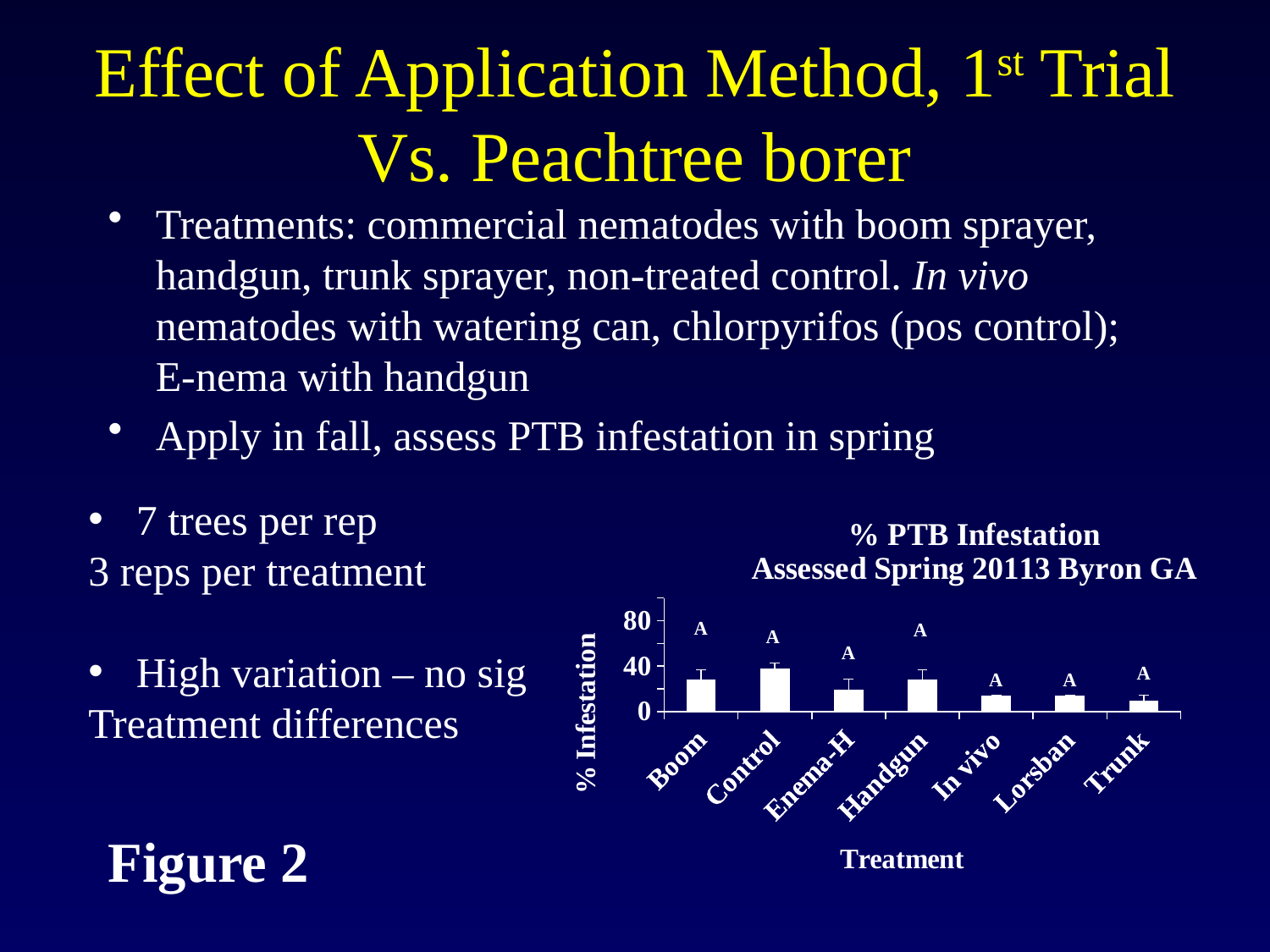
Which has a higher % infestation, Boom or In vivo? Boom Which treatment has the highest % infestation in the chart? Control What kind of chart is shown on the slide? bar chart What is the label on the x axis of the chart? Treatment Is the value for Boom greater or less than 40? less Which has a higher % infestation, Handgun or Lorsban? Handgun Is the value for Enema-H greater or less than 40? less How many treatment categories are plotted on the x axis of the chart? 7 Which has a higher % infestation, Control or Trunk? Control What is the title of the chart? % PTB Infestation Assessed Spring 20113 Byron GA Is the value for Trunk greater or less than 40? less